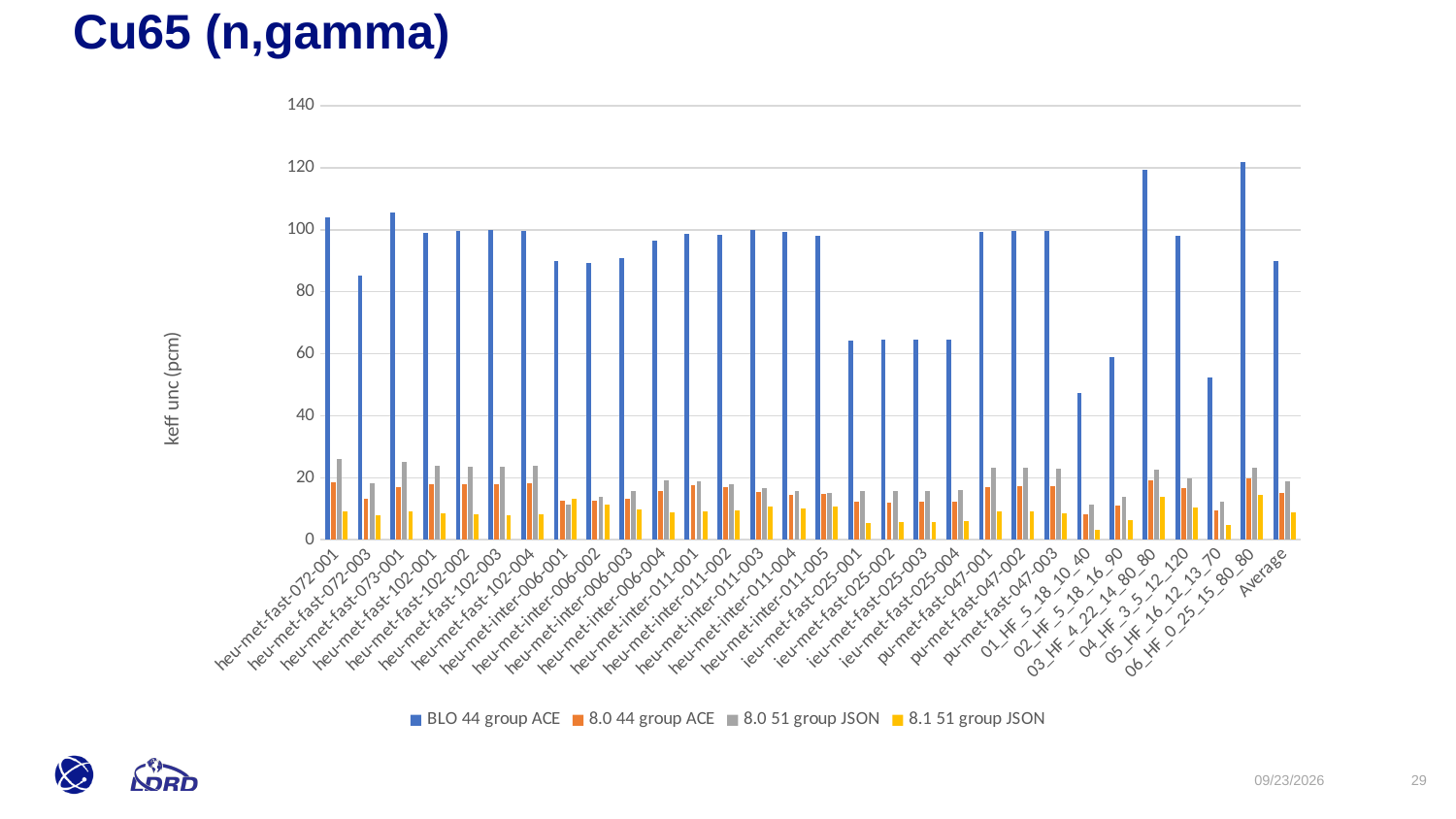
What is the label of the y axis? keff unc (pcm) Is the BLO 44 group ACE value for 05_HF_16_12_13_70 greater or less than 60? less Is the BLO 44 group ACE value for ieu-met-fast-025-001 greater or less than 80? less For heu-met-fast-072-001, which series has the larger value: 8.0 51 group JSON or 8.1 51 group JSON? 8.0 51 group JSON Is the BLO 44 group ACE value for heu-met-fast-072-003 greater or less than 80? greater What kind of chart is shown on the slide? bar chart How many categories are shown along the x axis? 30 How many series does the legend list? 4 Which category has the lowest value for the BLO 44 group ACE series? 01_HF_5_18_10_40 Which is larger for the BLO 44 group ACE series: heu-met-fast-072-001 or heu-met-fast-072-003? heu-met-fast-072-001